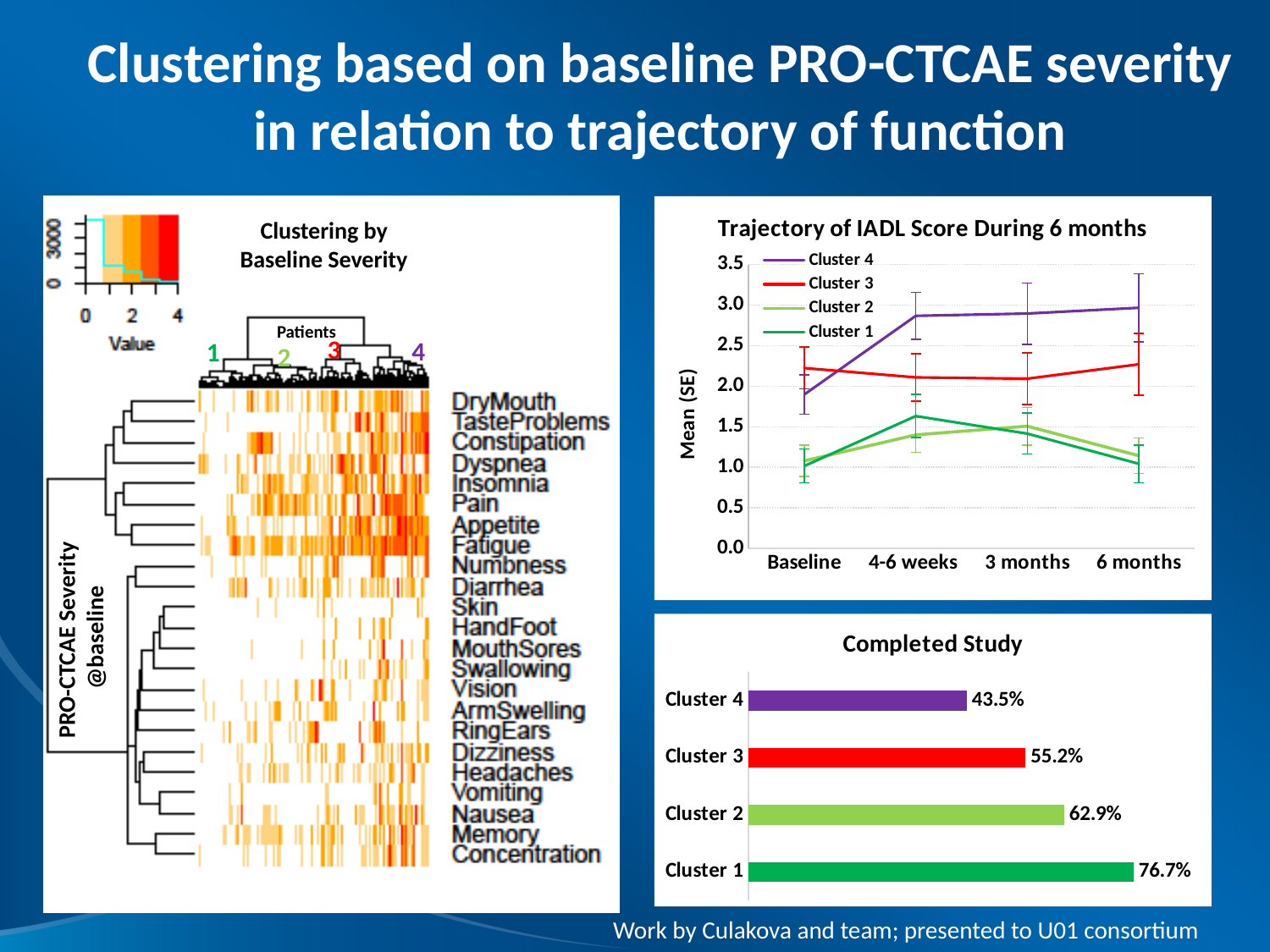
In the Completed Study chart, what percentage is shown for Cluster 1? 76.7% How many series does the legend of the Trajectory of IADL Score During 6 months chart list? 4 In the Trajectory of IADL Score During 6 months chart, which cluster has the highest mean at 6 months? Cluster 4 In the Trajectory of IADL Score During 6 months chart, does the Cluster 4 line rise or fall from Baseline to 6 months? Rise In the Completed Study chart, which cluster has the highest completion percentage? Cluster 1 In the Completed Study chart, which cluster has the lowest completion percentage? Cluster 4 What kind of chart is the Completed Study chart? Bar chart In the Trajectory of IADL Score During 6 months chart, is the mean for Cluster 4 at 6 months greater or less than 2.5? greater In the Completed Study chart, what is the difference in percentage points between Cluster 2 and Cluster 3? 7.7 In the Completed Study chart, which is larger, the value for Cluster 3 or the value for Cluster 2? Cluster 2 In the Completed Study chart, what percentage is shown for Cluster 4? 43.5% How many time points are shown on the x axis of the Trajectory of IADL Score During 6 months chart? 4